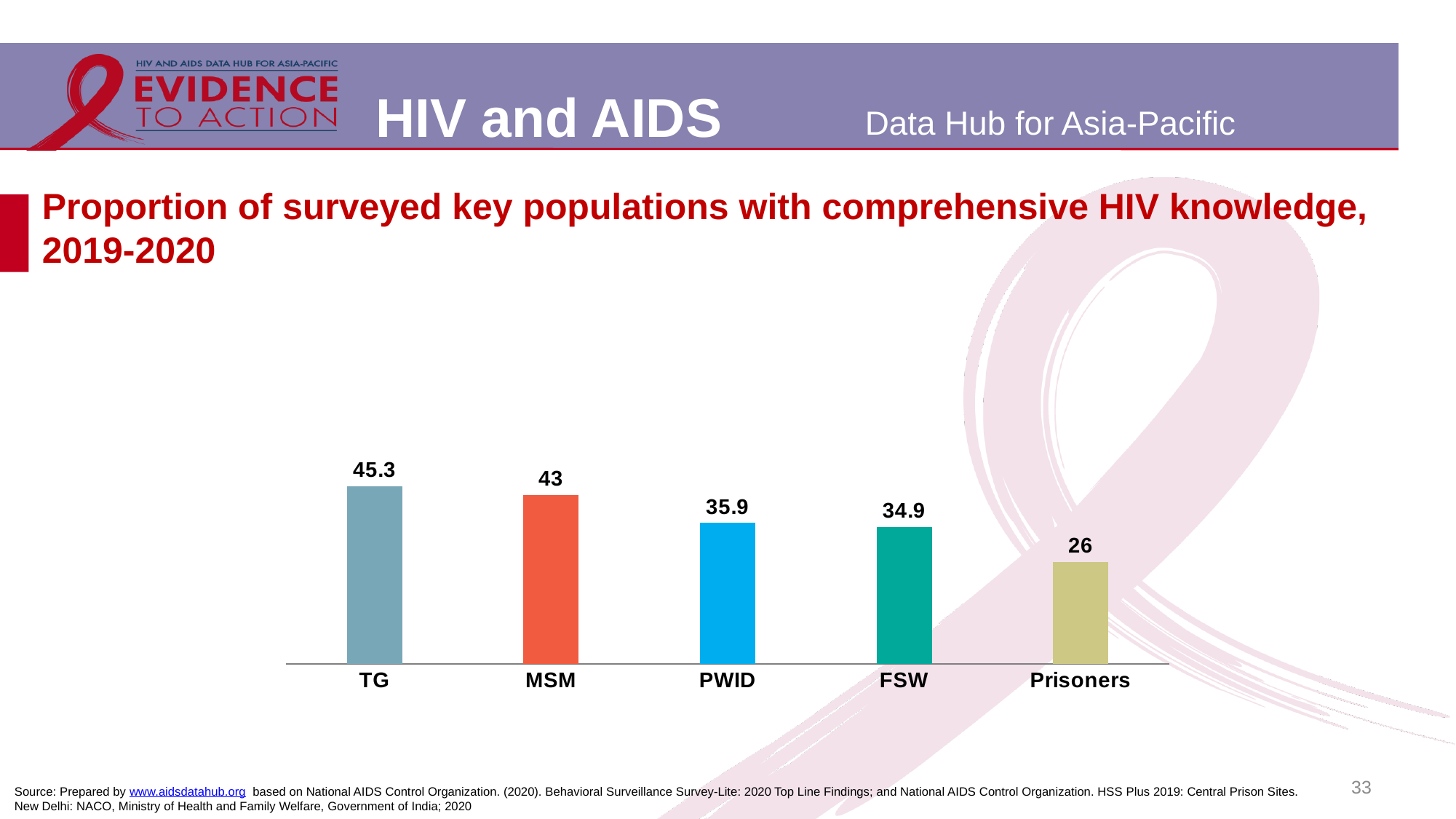
How many key populations are shown in the chart? 5 What kind of chart is shown on the slide? Bar chart What is the value for MSM? 43 What is the value for TG? 45.3 Which key population has the lowest value? Prisoners Which is larger, the value for MSM or the value for FSW? MSM Do the values rise or fall from left to right across the categories? Fall Which key population has the highest value? TG What is the value for Prisoners? 26 What is the difference between the values for TG and Prisoners? 19.3 What is the difference between the values for PWID and FSW? 1 What is the value for PWID? 35.9